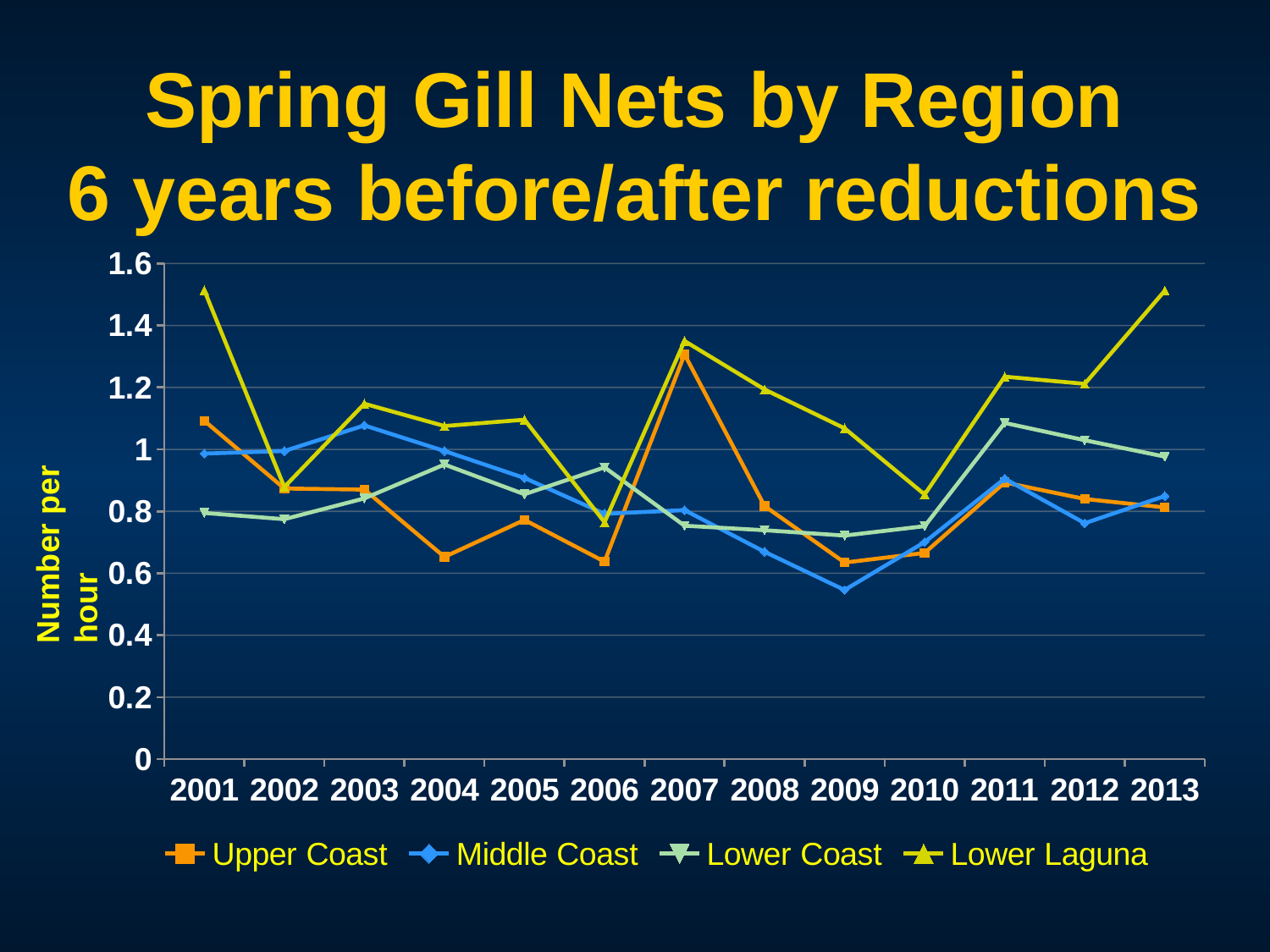
How many years are shown along the x axis? 13 Is the value for Lower Coast in 2011 greater or less than 1? greater Is the value for Lower Laguna in 2001 greater or less than 1.4? greater In 2003, which is larger: the value for Middle Coast or the value for Upper Coast? Middle Coast What is the label on the y axis? Number per hour How many series does the legend list? 4 Is the value for Middle Coast in 2009 greater or less than 0.6? less Which series has the lowest value in 2009? Middle Coast Which series has the highest value in 2013? Lower Laguna Does the Lower Laguna line rise or fall from 2010 to 2013? Rises What kind of chart is shown on the slide? Line chart